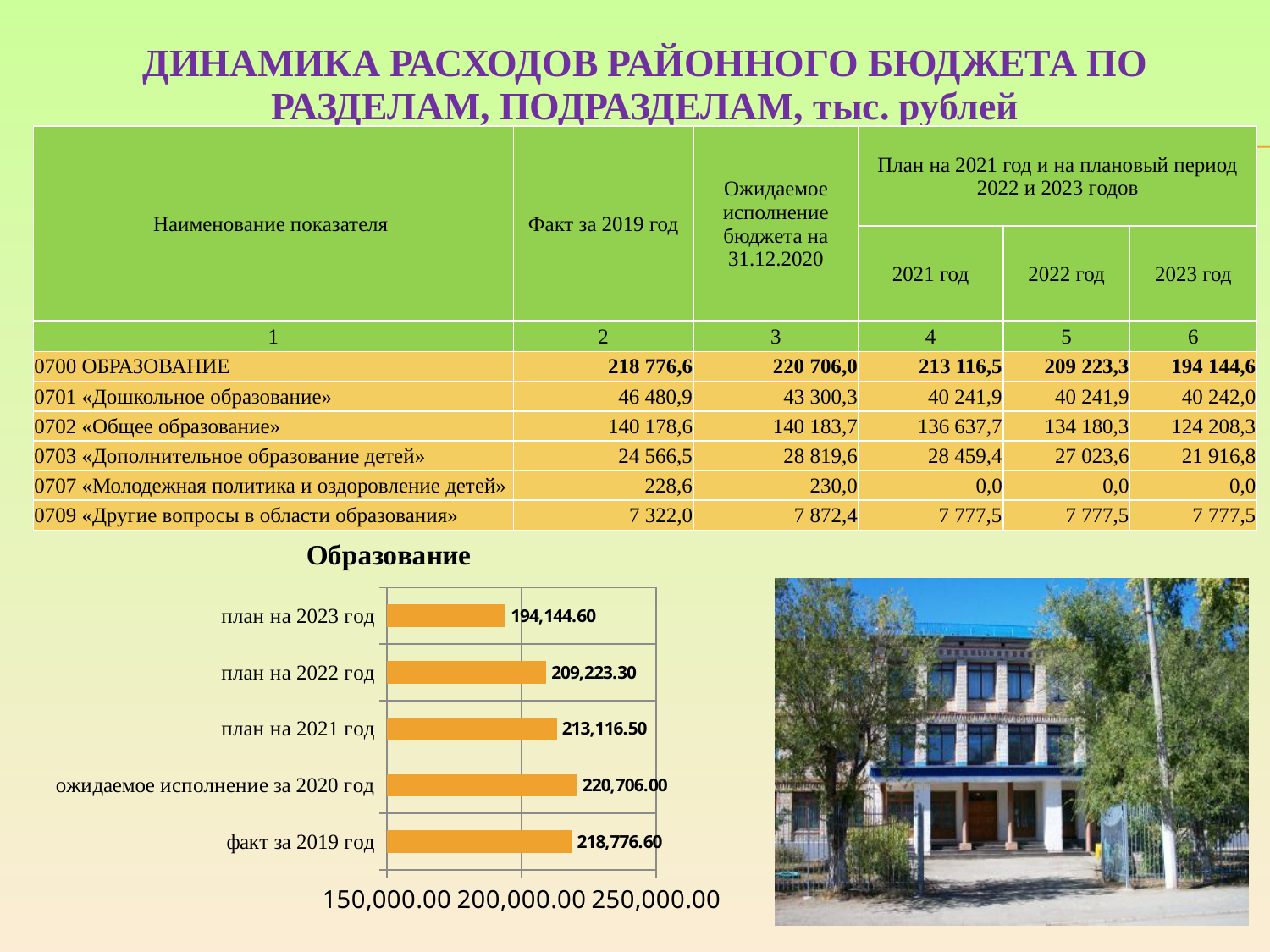
What is the value for ожидаемое исполнение за 2020 год in the Образование chart? 220,706.00 What is the difference between ожидаемое исполнение за 2020 год and факт за 2019 год in the Образование chart? 1,929.40 Is the value for план на 2023 год in the Образование chart greater or less than 200,000.00? less What kind of chart is the Образование chart? bar chart What is the difference between план на 2021 год and план на 2023 год in the Образование chart? 18,971.90 Which category has the highest value in the Образование chart? ожидаемое исполнение за 2020 год In the Образование chart, which is larger: план на 2022 год or план на 2023 год? план на 2022 год What is the value for факт за 2019 год in the Образование chart? 218,776.60 Which category has the lowest value in the Образование chart? план на 2023 год What is the value for план на 2021 год in the Образование chart? 213,116.50 How many categories are shown in the Образование chart? 5 What is the value for план на 2023 год in the Образование chart? 194,144.60